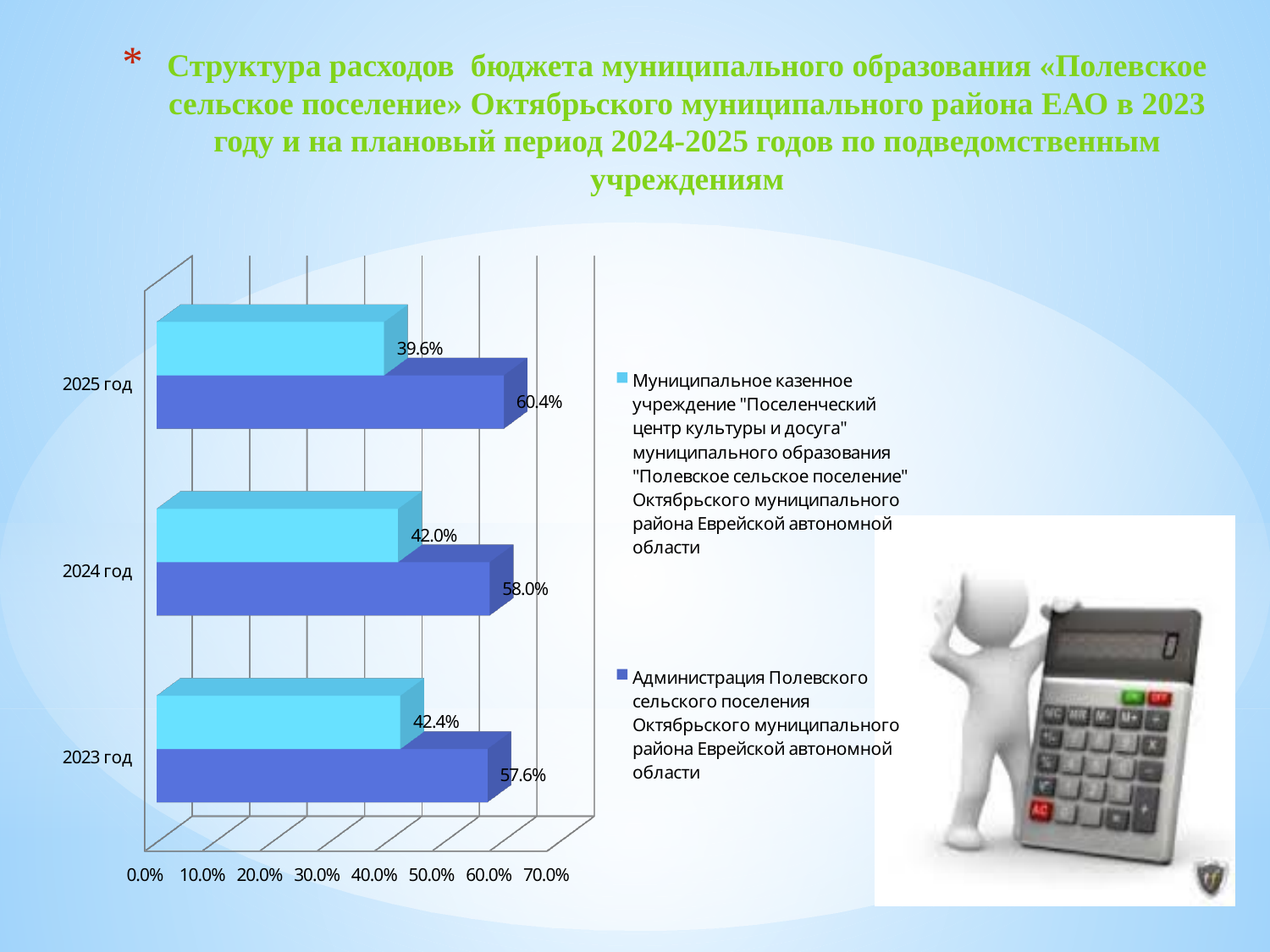
How many years (categories) are shown on the chart? 3 What kind of chart is shown on the slide? Bar chart What is the value for the Муниципальное казенное учреждение "Поселенческий центр культуры и досуга" series in 2024 год? 42.0% In which year is the value for the Администрация Полевского сельского поселения series highest? 2025 год What is the value for the Администрация Полевского сельского поселения series in 2024 год? 58.0% Does the value for the Администрация Полевского сельского поселения series rise or fall from 2023 год to 2025 год? Rise What is the value for the Администрация Полевского сельского поселения series in 2025 год? 60.4% How many series does the legend list? 2 In which year is the value for the Муниципальное казенное учреждение "Поселенческий центр культуры и досуга" series lowest? 2025 год What is the difference between the two series' values in 2025 год? 20.8% What is the value for the Муниципальное казенное учреждение "Поселенческий центр культуры и досуга" series in 2023 год? 42.4% In 2023 год, which series has the larger value? Администрация Полевского сельского поселения